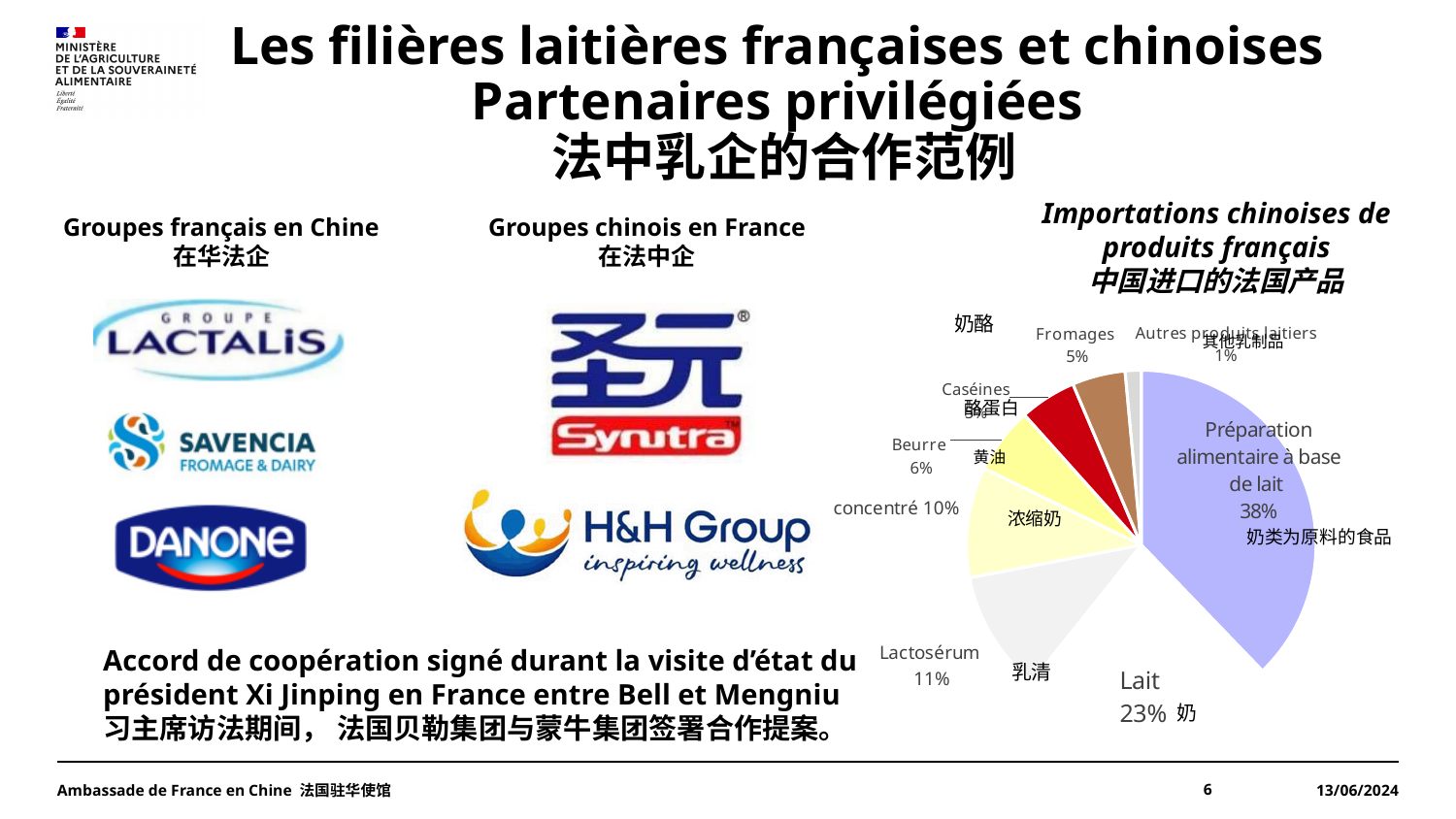
What is the French title of the pie chart? Importations chinoises de produits français How many slices does the pie chart have? 8 Which category has the smallest slice in the pie chart? Autres produits laitiers In the pie chart, what share is shown for 'Lactosérum'? 11% In the pie chart, what is the difference in percentage points between 'Préparation alimentaire à base de lait' and 'Lait'? 15 In the pie chart, which is larger: the share for 'Lactosérum' or the share for 'concentré'? Lactosérum In the pie chart, what share is shown for 'Beurre'? 6% What kind of chart is shown under the title 'Importations chinoises de produits français'? pie chart In the pie chart, what share is shown for 'Préparation alimentaire à base de lait'? 38% In the pie chart, what share is shown for 'Lait'? 23% In the pie chart, what share is shown for 'Fromages'? 5% Which category has the largest slice in the pie chart? Préparation alimentaire à base de lait